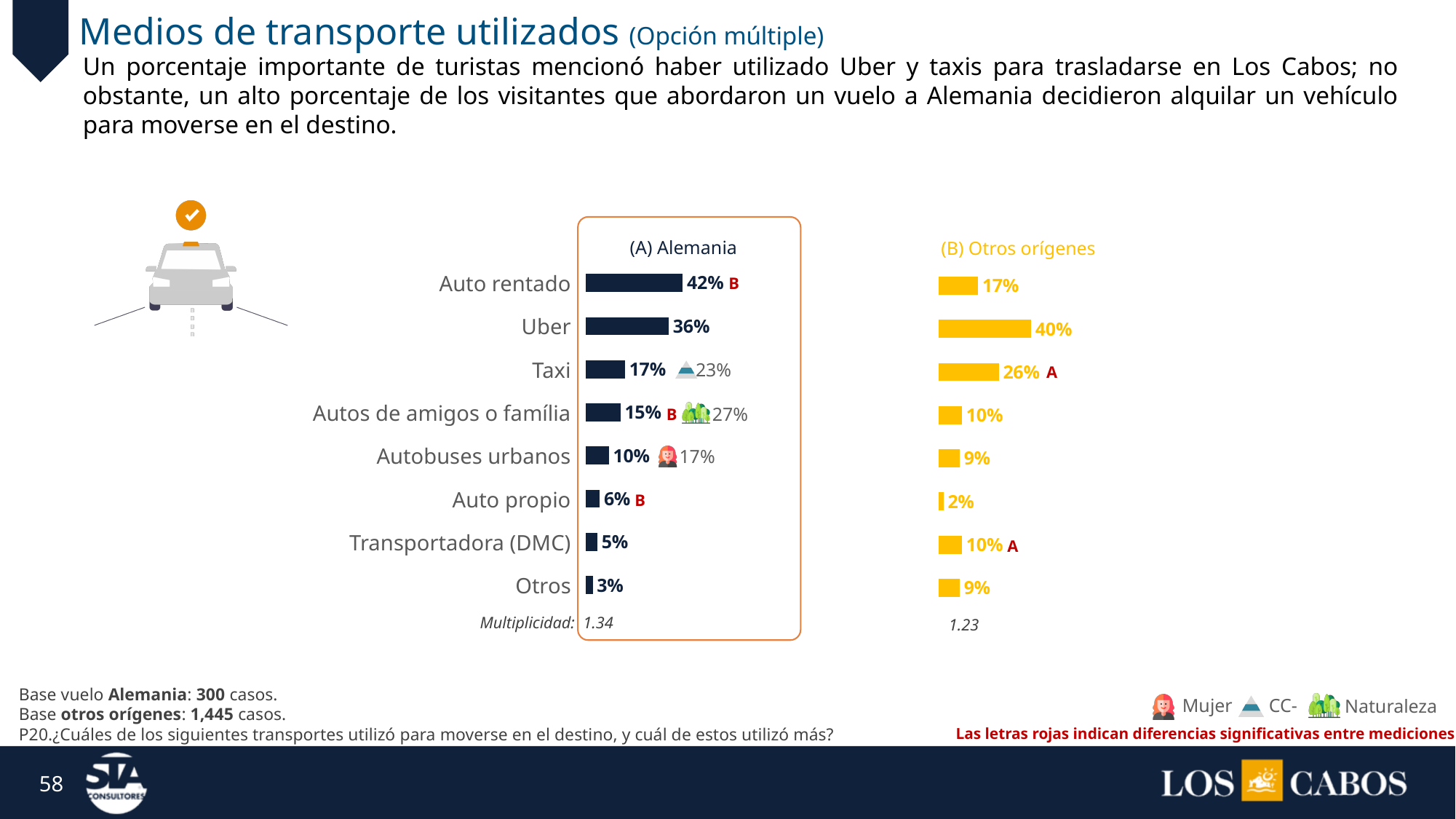
What type of chart is used to show the means of transport? Bar chart What is the difference between the Auto rentado value in the (A) Alemania chart and the Auto rentado value in the (B) Otros orígenes chart? 25% In the (B) Otros orígenes chart, which means of transport has the lowest percentage? Auto propio What is the Multiplicidad value shown for the (A) Alemania chart? 1.34 Which is larger for Uber: the (A) Alemania value or the (B) Otros orígenes value? (B) Otros orígenes In the (A) Alemania chart, which means of transport has the lowest percentage? Otros In the (B) Otros orígenes chart, what is the value for Taxi? 26% In the (B) Otros orígenes chart, what percentage of tourists used Uber? 40% How many means of transport categories are listed in the charts? 8 In the (A) Alemania chart, what percentage of tourists used Auto rentado? 42% In the (A) Alemania chart, what is the difference between Uber and Taxi? 19% In the (A) Alemania chart, which means of transport has the highest percentage? Auto rentado